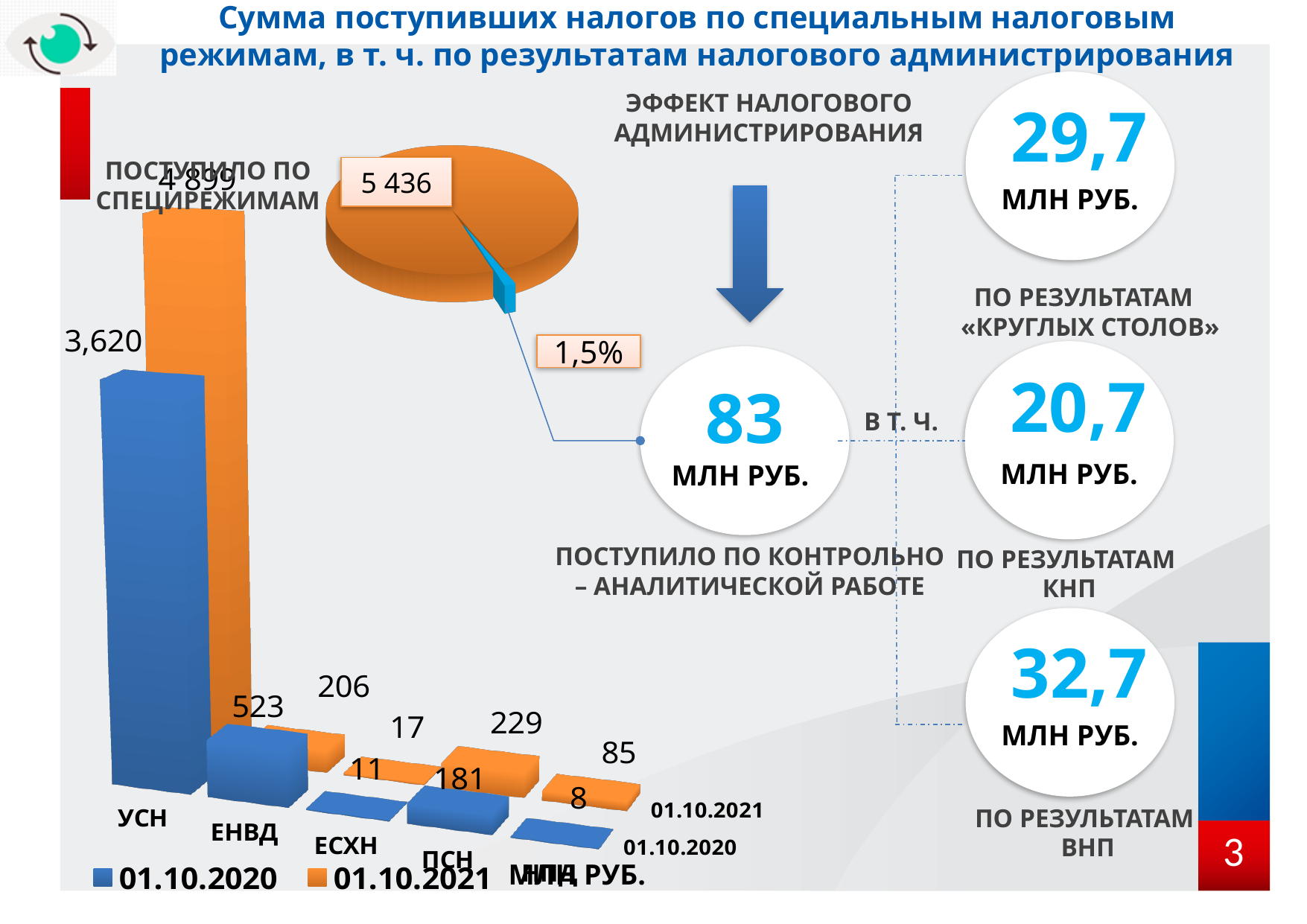
In the bar chart, which is larger for ПСН: the 01.10.2020 value or the 01.10.2021 value? 01.10.2021 In the bar chart, which category has the lowest value in the 01.10.2020 series? НПД In the bar chart, what is the value for ЕНВД in the 01.10.2020 series? 523 In the bar chart, what is the difference between the 01.10.2020 and 01.10.2021 values for ЕНВД? 317 In the bar chart, what is the value for УСН in the 01.10.2021 series? 4 899 How many categories are shown in the bar chart? 5 How many series does the bar chart legend list? 2 In the bar chart, what is the value for НПД in the 01.10.2020 series? 8 In the bar chart, what is the value for ПСН in the 01.10.2021 series? 229 In the bar chart, which category has the highest value in the 01.10.2021 series? УСН In the bar chart, what is the value for УСН in the 01.10.2020 series? 3,620 What share of the pie chart does the small highlighted slice represent? 1,5%